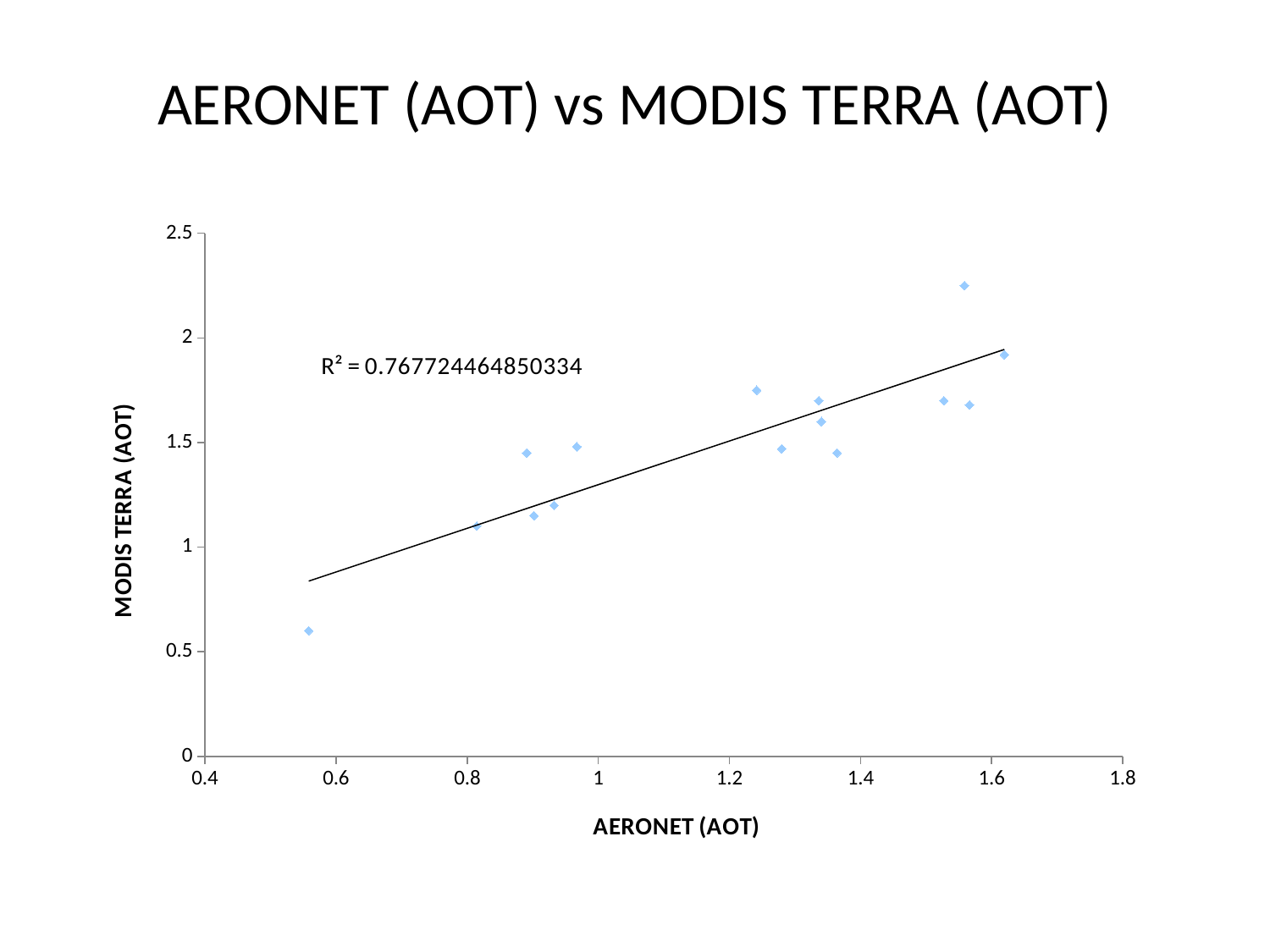
What is the label of the x axis? AERONET (AOT) What is the R² value printed on the chart? R² = 0.767724464850334 Do the MODIS TERRA (AOT) values generally rise or fall as AERONET (AOT) increases along the x axis? Rise Is the MODIS TERRA (AOT) value of the point with the largest AERONET (AOT) value greater or less than 1.5? greater How many data points are plotted on the chart? 15 Is the lowest MODIS TERRA (AOT) value plotted greater or less than 1? less What kind of chart is shown on the slide? Scatter plot Is the highest MODIS TERRA (AOT) value plotted greater or less than 2? greater What is the title of the chart? AERONET (AOT) vs MODIS TERRA (AOT) What is the maximum value shown on the y axis? 2.5